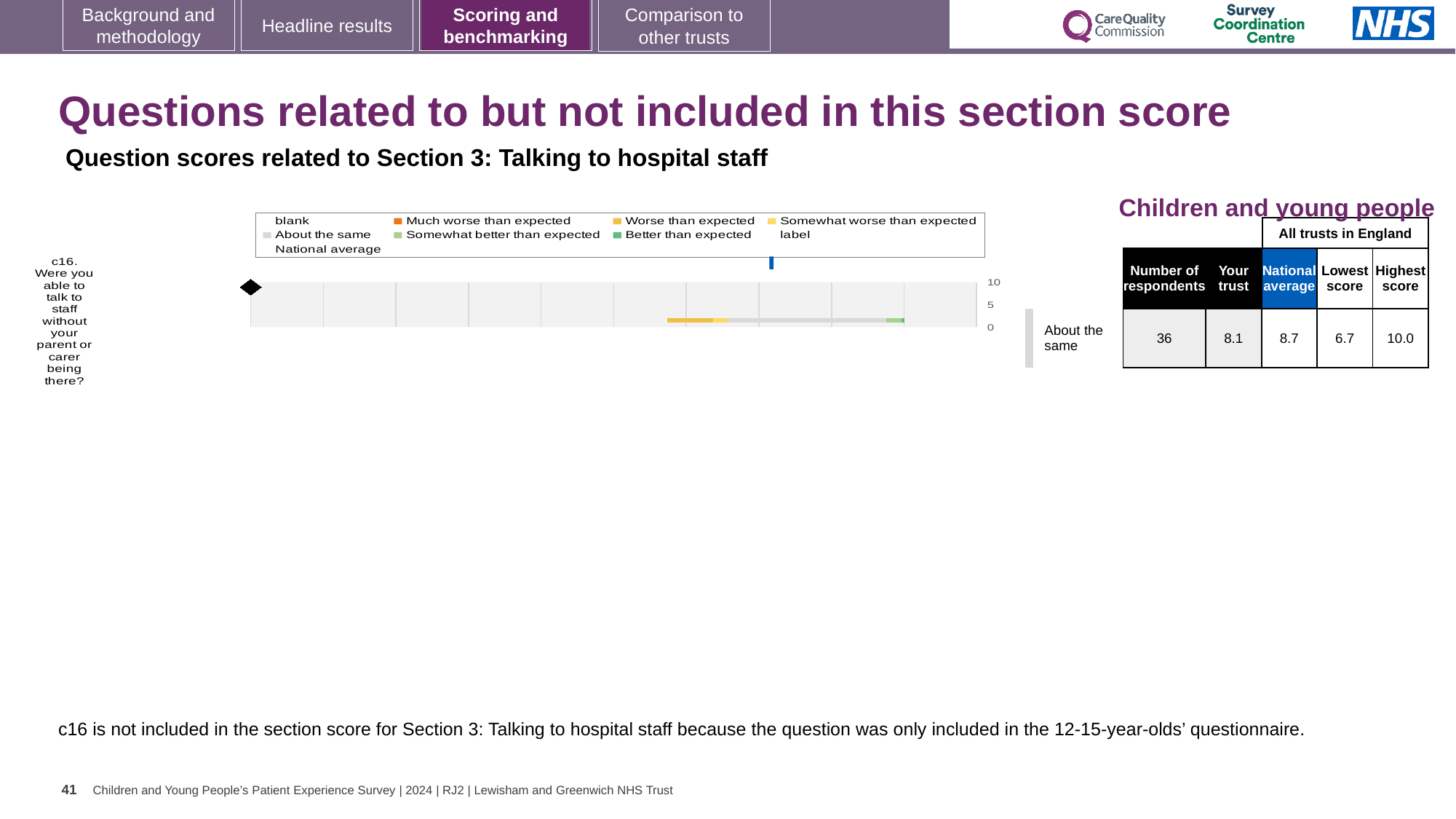
Which question code is plotted on the chart? c16 What is the difference between the highest score and the lowest score for c16? 3.3 What is the difference between the national average and the 'Your trust' score for c16? 0.6 What is the national average score for c16? 8.7 What is the 'Your trust' score for c16? 8.1 Which is higher for c16, the 'Your trust' score or the national average? National average What is the lowest score across all trusts in England for c16? 6.7 How many respondents answered c16? 36 How many survey questions are plotted on the chart? 1 What benchmark category is shown next to the c16 bar? About the same What is the highest score across all trusts in England for c16? 10.0 What kind of chart is used to show the c16 question score? bar chart